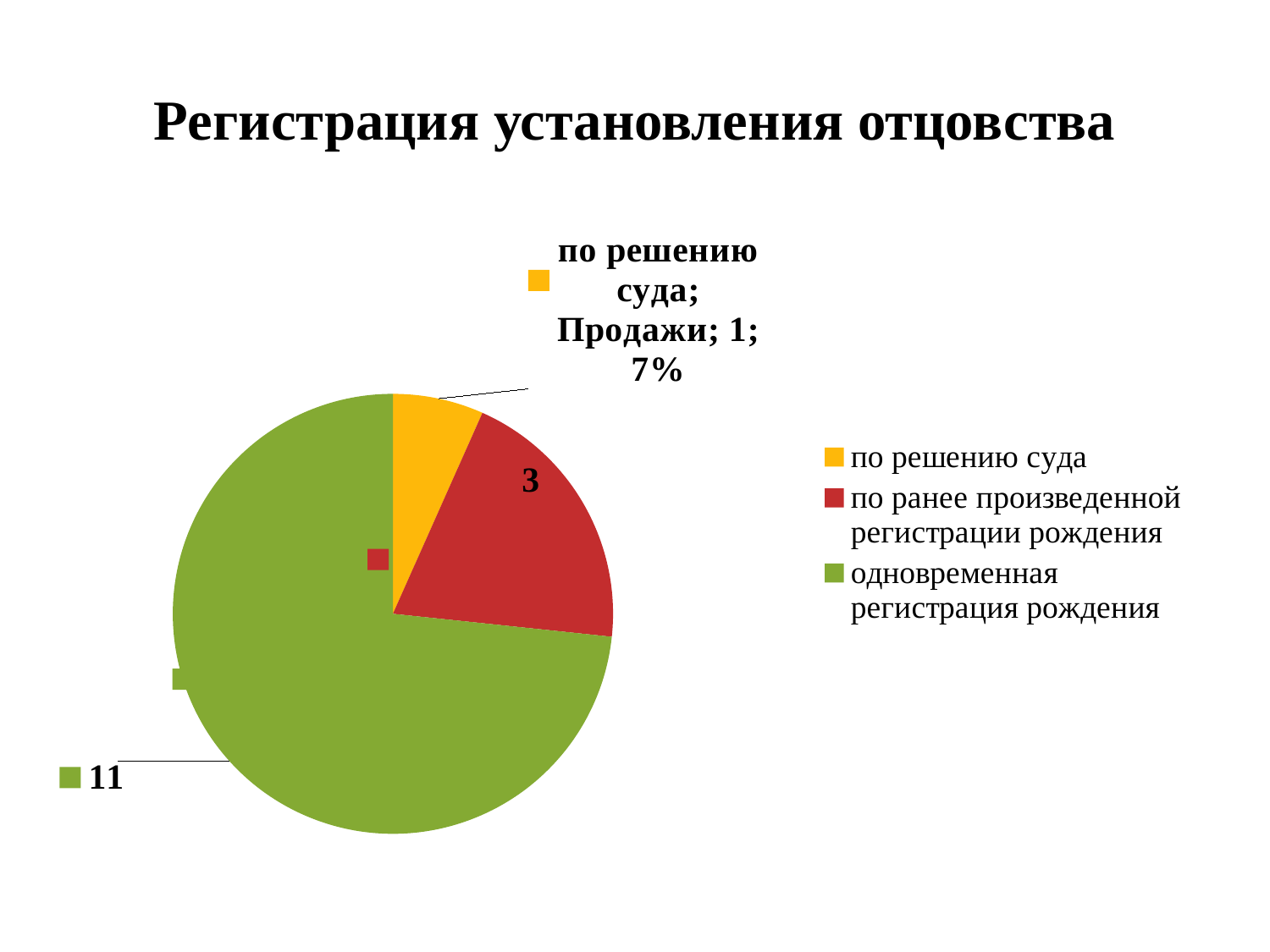
What kind of chart is shown on the slide? pie chart What is the difference between the values for "одновременная регистрация рождения" and "по ранее произведенной регистрации рождения"? 8 Which category has the largest slice? одновременная регистрация рождения Which colour represents "по ранее произведенной регистрации рождения" in the legend? red What percentage share is shown for "по решению суда"? 7% What is the title of the chart? Регистрация установления отцовства How many entries does the legend list? 3 How many slices does the pie chart have? 3 What is the value for "по ранее произведенной регистрации рождения"? 3 Which category has the smallest slice? по решению суда What is the value for "по решению суда"? 1 What is the value for "одновременная регистрация рождения"? 11